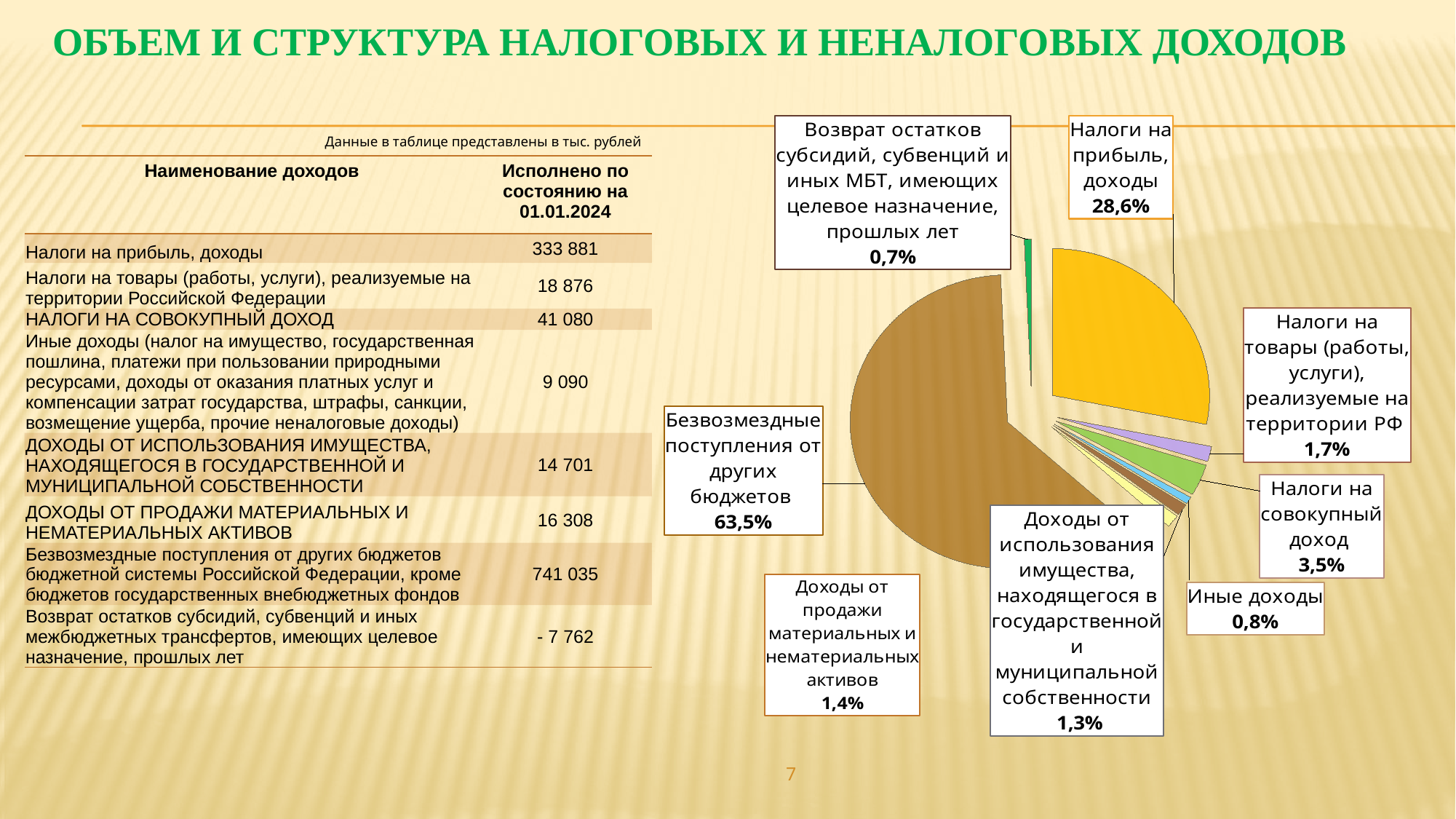
What share of the pie chart is labelled for "Иные доходы"? 0,8% Which category has the largest slice in the pie chart? Безвозмездные поступления от других бюджетов What is the difference in percentage points between the shares for "Безвозмездные поступления от других бюджетов" and "Налоги на прибыль, доходы"? 34,9 What colour is the slice for "Налоги на прибыль, доходы" in the pie chart? Yellow Which category has the smallest slice in the pie chart? Возврат остатков субсидий, субвенций и иных МБТ, имеющих целевое назначение, прошлых лет What share of the pie chart is labelled for "Налоги на прибыль, доходы"? 28,6% Which slice is larger in the pie chart: "Налоги на совокупный доход" or "Налоги на товары (работы, услуги), реализуемые на территории РФ"? Налоги на совокупный доход How many slices does the pie chart have? 8 What share of the pie chart is labelled for "Доходы от продажи материальных и нематериальных активов"? 1,4% What share of the pie chart is labelled for "Безвозмездные поступления от других бюджетов"? 63,5% What kind of chart is shown on the slide? Pie chart What share of the pie chart is labelled for "Налоги на совокупный доход"? 3,5%